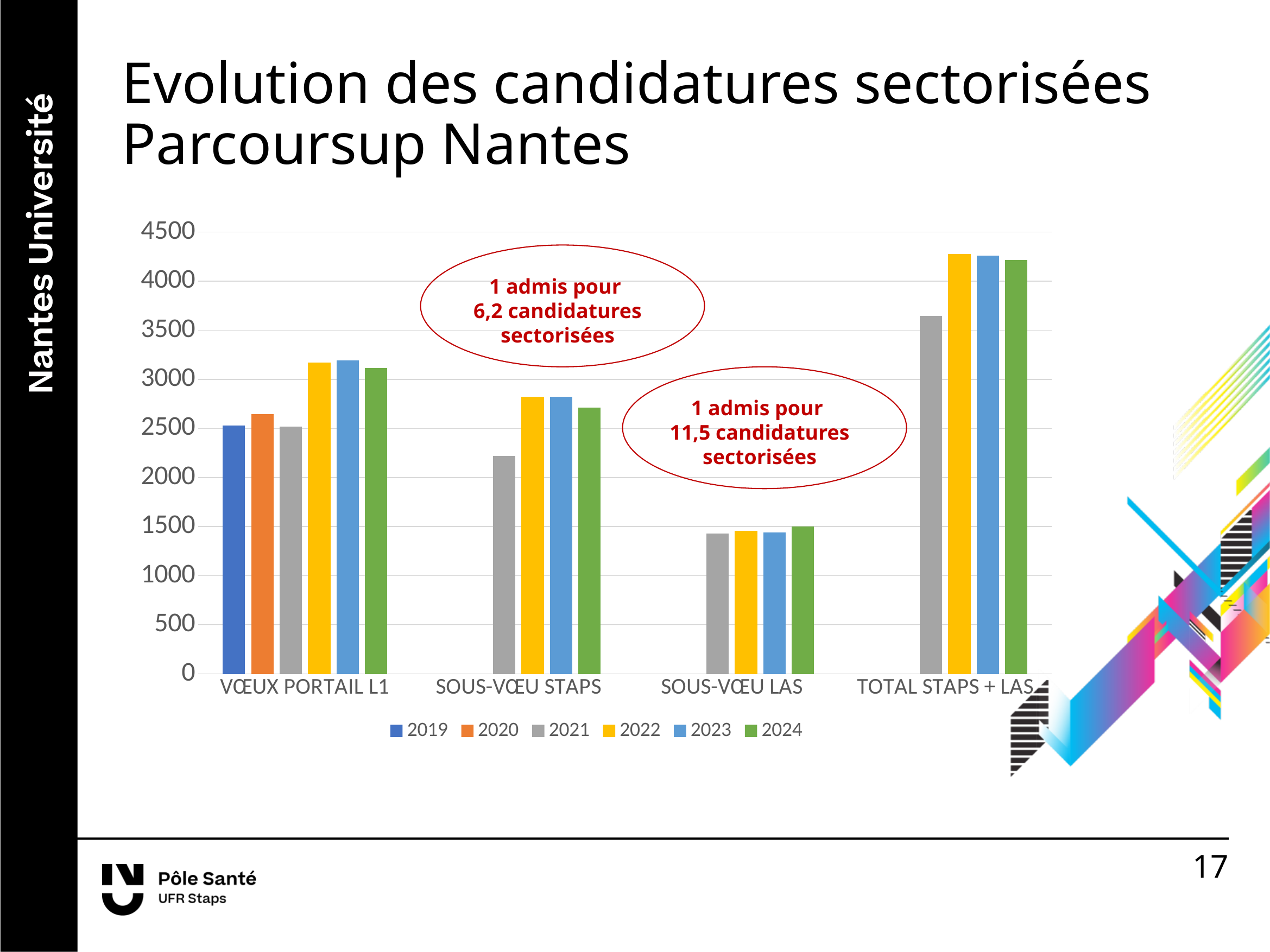
How many categories are shown on the x axis? 4 Is the 2024 value for SOUS-VŒU LAS greater or less than 1000? greater Which category has the highest 2024 value? TOTAL STAPS + LAS Is the 2021 value for SOUS-VŒU STAPS greater or less than 2500? less For SOUS-VŒU STAPS, which is larger: the 2021 value or the 2022 value? 2022 Is the 2022 value for VŒUX PORTAIL L1 greater or less than 3000? greater For VŒUX PORTAIL L1, which is larger: the 2021 value or the 2022 value? 2022 What kind of chart is shown on the slide? bar chart How many series does the legend list? 6 Which category has the lowest 2021 value? SOUS-VŒU LAS